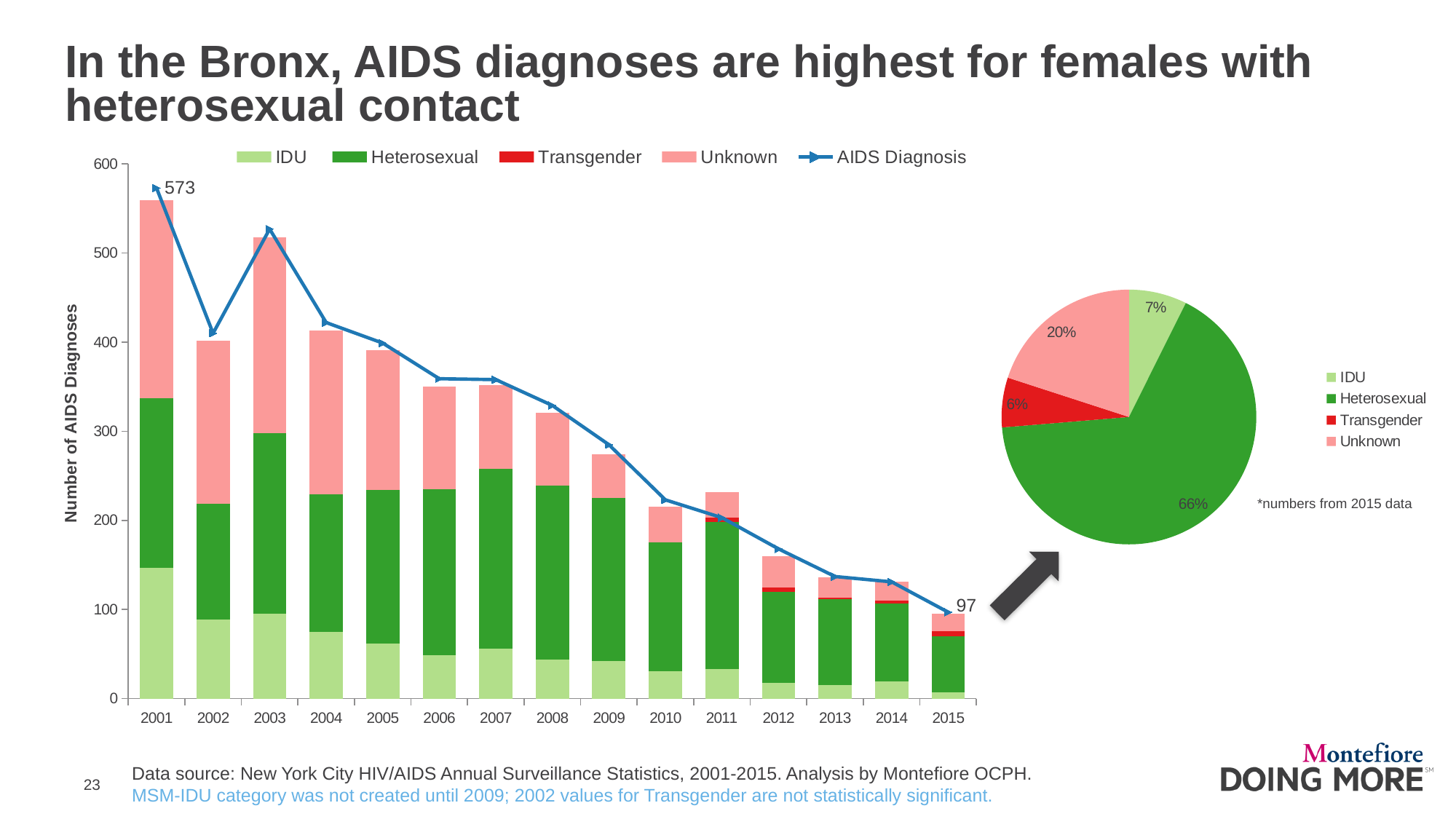
In the bar chart, which year has the higher AIDS Diagnosis value, 2002 or 2003? 2003 What kind of chart is the chart on the left of the slide? Combination bar and line chart (stacked bars with a line) In the bar chart, does the AIDS Diagnosis line generally rise or fall from 2001 to 2015? Fall How many series does the legend of the bar chart list? 5 In the pie chart, what share is Unknown? 20% In the bar chart, what is the difference between the labelled AIDS Diagnosis values for 2001 and 2015? 476 How many years are shown on the x axis of the bar chart? 15 In the pie chart, which category has the smallest slice? Transgender In the bar chart, what is the AIDS Diagnosis value labelled for 2001? 573 In the bar chart, what is the AIDS Diagnosis value labelled for 2015? 97 In the pie chart, what share is Heterosexual? 66% In the bar chart, is the AIDS Diagnosis value for 2008 greater or less than 300? greater